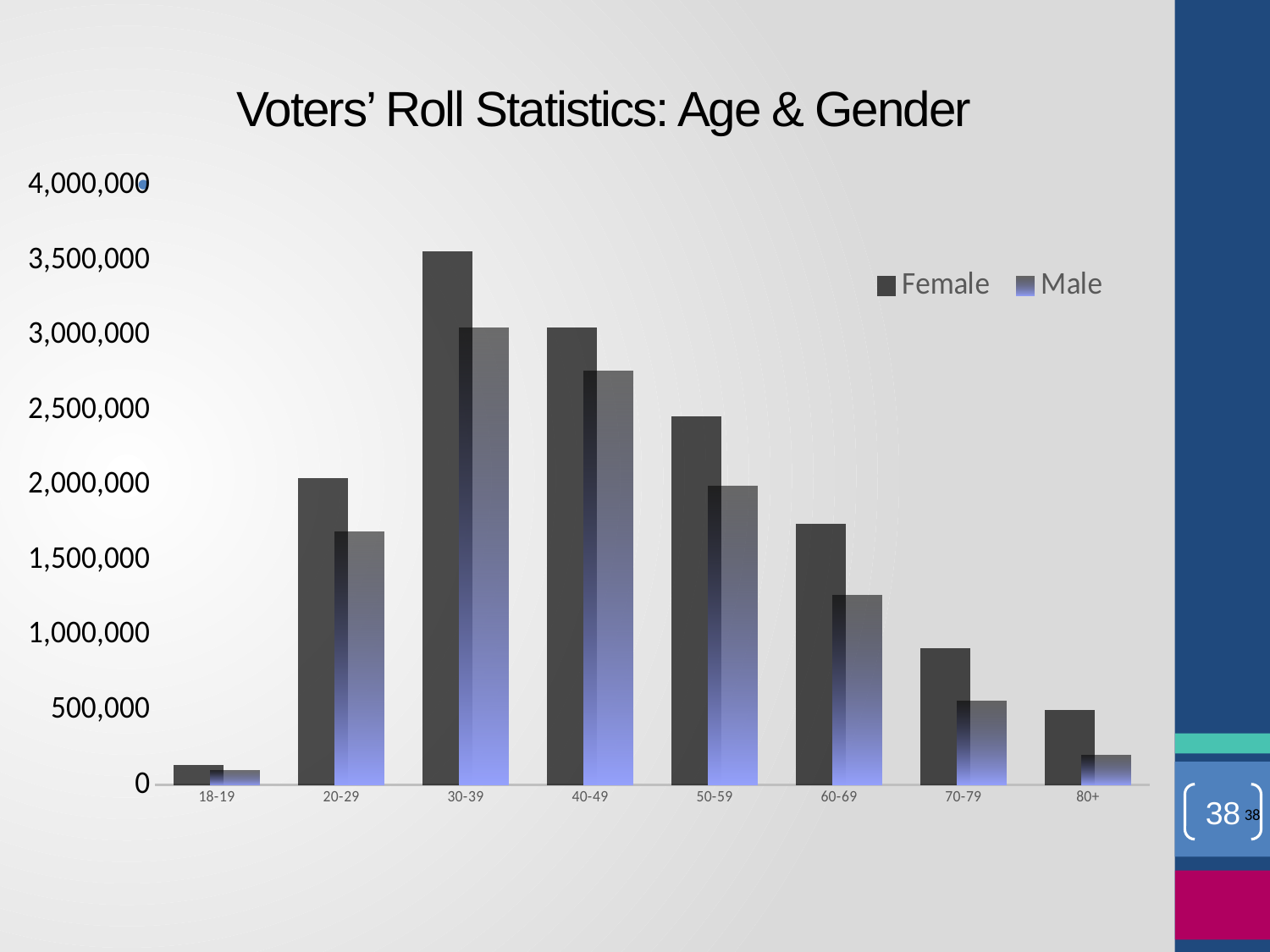
How many series does the legend list? 2 Is the Male value for 80+ greater or less than 500,000? less In the 40-49 age group, which is larger, the Female value or the Male value? Female Which age group has the lowest Male value? 18-19 From the 30-39 age group to the 80+ age group, do the Female values rise or fall? fall Which age group has the highest Female value? 30-39 Is the Male value for 20-29 greater or less than 2,000,000? less How many age groups are shown on the x axis? 8 Is the Female value for 60-69 greater or less than 1,500,000? greater What kind of chart is shown on the slide? Bar chart What is the title of the chart? Voters' Roll Statistics: Age & Gender